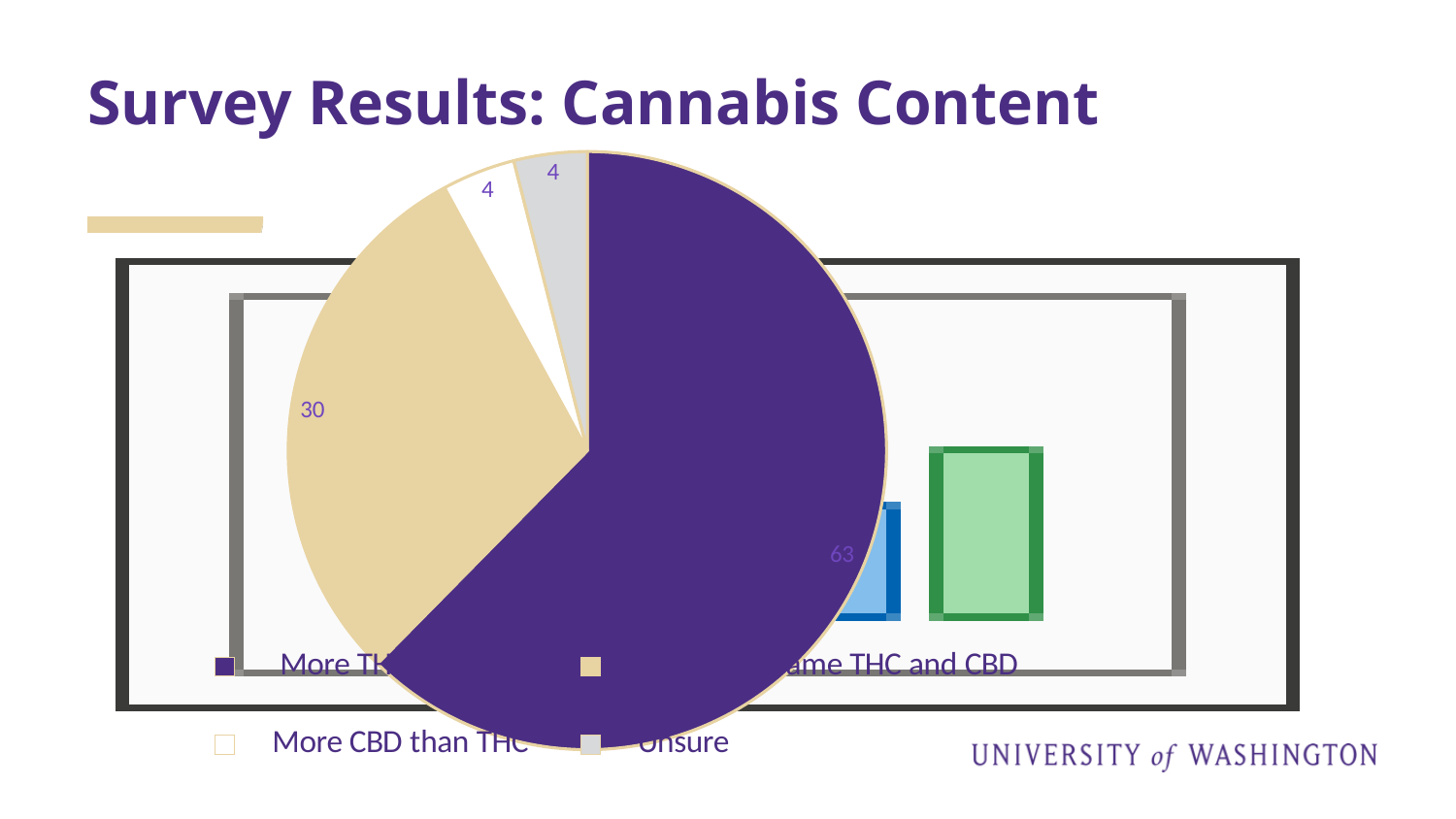
What is the value of the largest slice in the pie chart? 63 What kind of chart is shown on the slide? pie chart What is the smallest value labelled on the pie chart? 4 What is the title of the slide? Survey Results: Cannabis Content How many slices does the pie chart have? 4 Which legend entry corresponds to the white slice? More CBD than THC What is the value shown for the More CBD than THC slice? 4 What is the value shown for the Unsure slice? 4 Which is larger: the purple slice or the tan slice? the purple slice Is the value of the purple slice greater or less than 50? greater What is the value shown on the tan (second-largest) slice? 30 What is the difference between the largest slice (63) and the tan slice (30)? 33